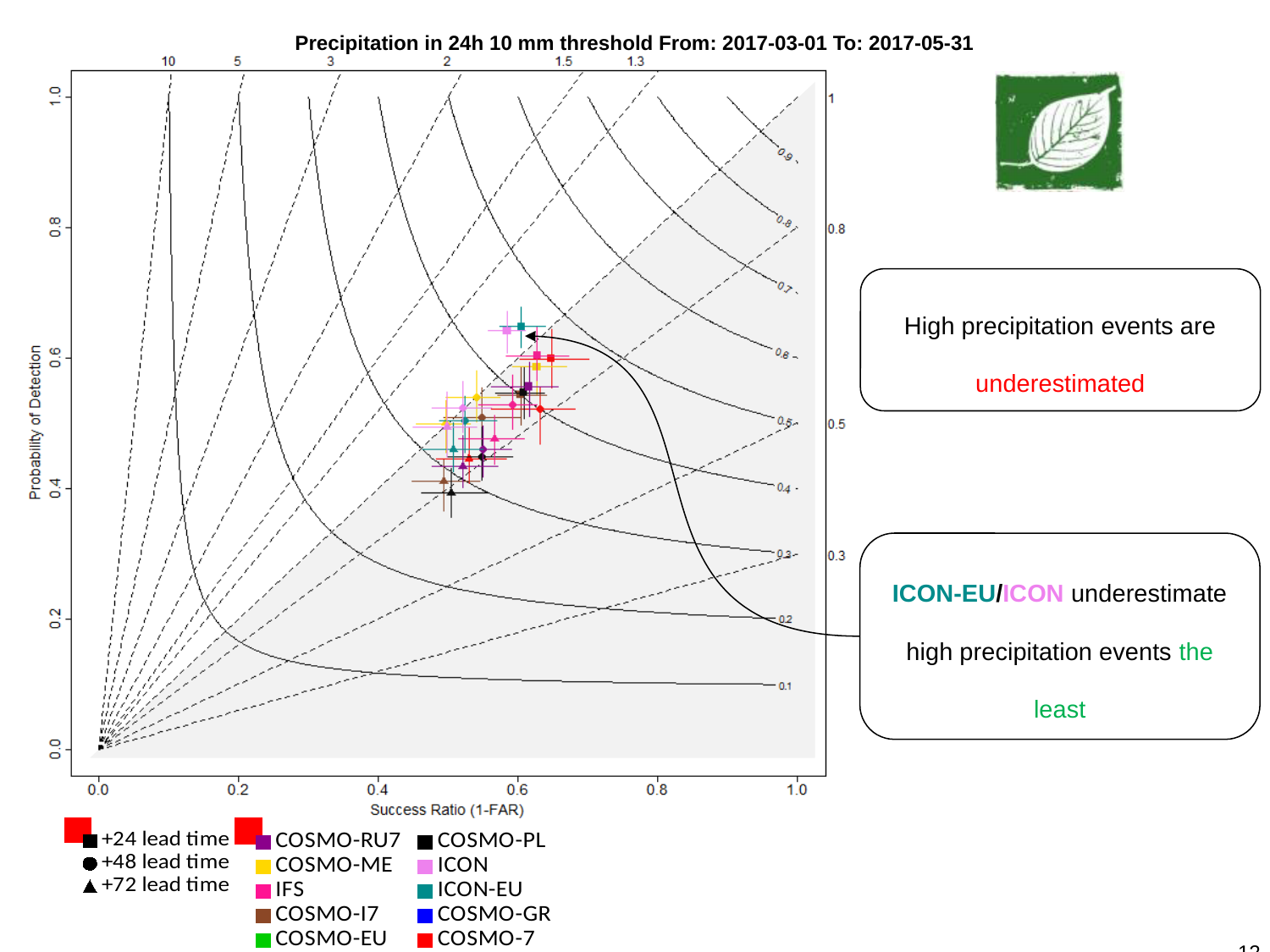
What kind of chart is shown on the slide? scatter plot Is the Success Ratio of the point with the lowest Probability of Detection greater or less than 0.4? greater Is the Success Ratio of every plotted point greater or less than 0.8? less Which has the higher Probability of Detection: the ICON-EU +24 lead time point or the COSMO-PL +72 lead time point? ICON-EU +24 lead time Is the highest Probability of Detection reached by any point greater or less than 0.8? less Which lead time does the point with the lowest Probability of Detection belong to? +72 lead time How many models are listed in the chart's legend? 10 How many lead times are distinguished by marker shape in the legend? 3 What is the label of the x axis of the chart? Success Ratio (1-FAR) What is the title of the chart? Precipitation in 24h 10 mm threshold From: 2017-03-01 To: 2017-05-31